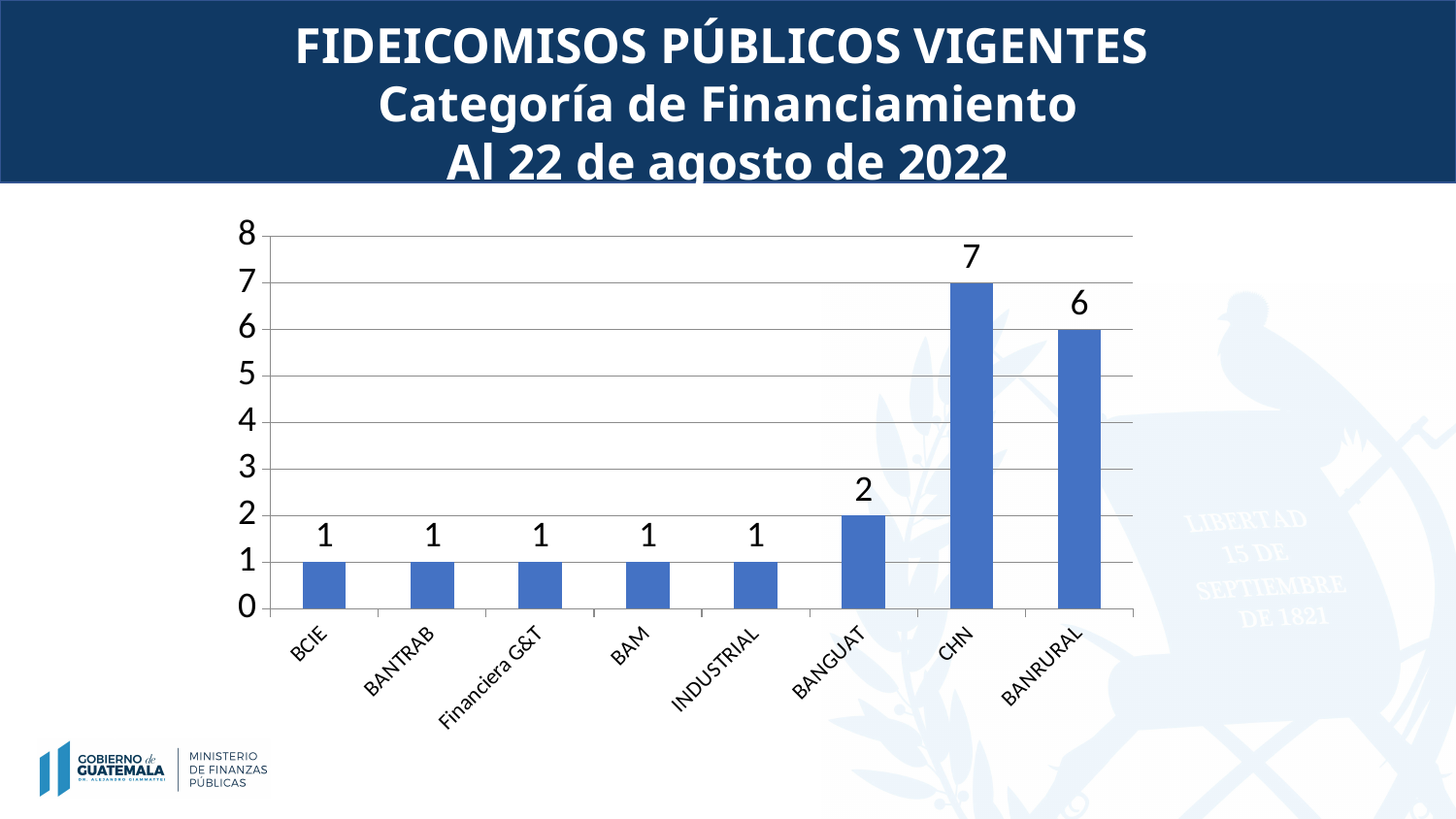
What kind of chart is shown on the slide? Bar chart What is the difference between the values for BANRURAL and BANGUAT? 4 What is the title of the chart on the slide? FIDEICOMISOS PÚBLICOS VIGENTES Categoría de Financiamiento Al 22 de agosto de 2022 How many categories have a value of 1? 5 What is the value for BANRURAL? 6 Which category has the highest value? CHN Which is larger, the value for BANGUAT or the value for INDUSTRIAL? BANGUAT How many categories are shown on the x axis? 8 What is the value for CHN? 7 What is the value for Financiera G&T? 1 What is the difference between the values for CHN and BANRURAL? 1 What is the value for BANGUAT? 2